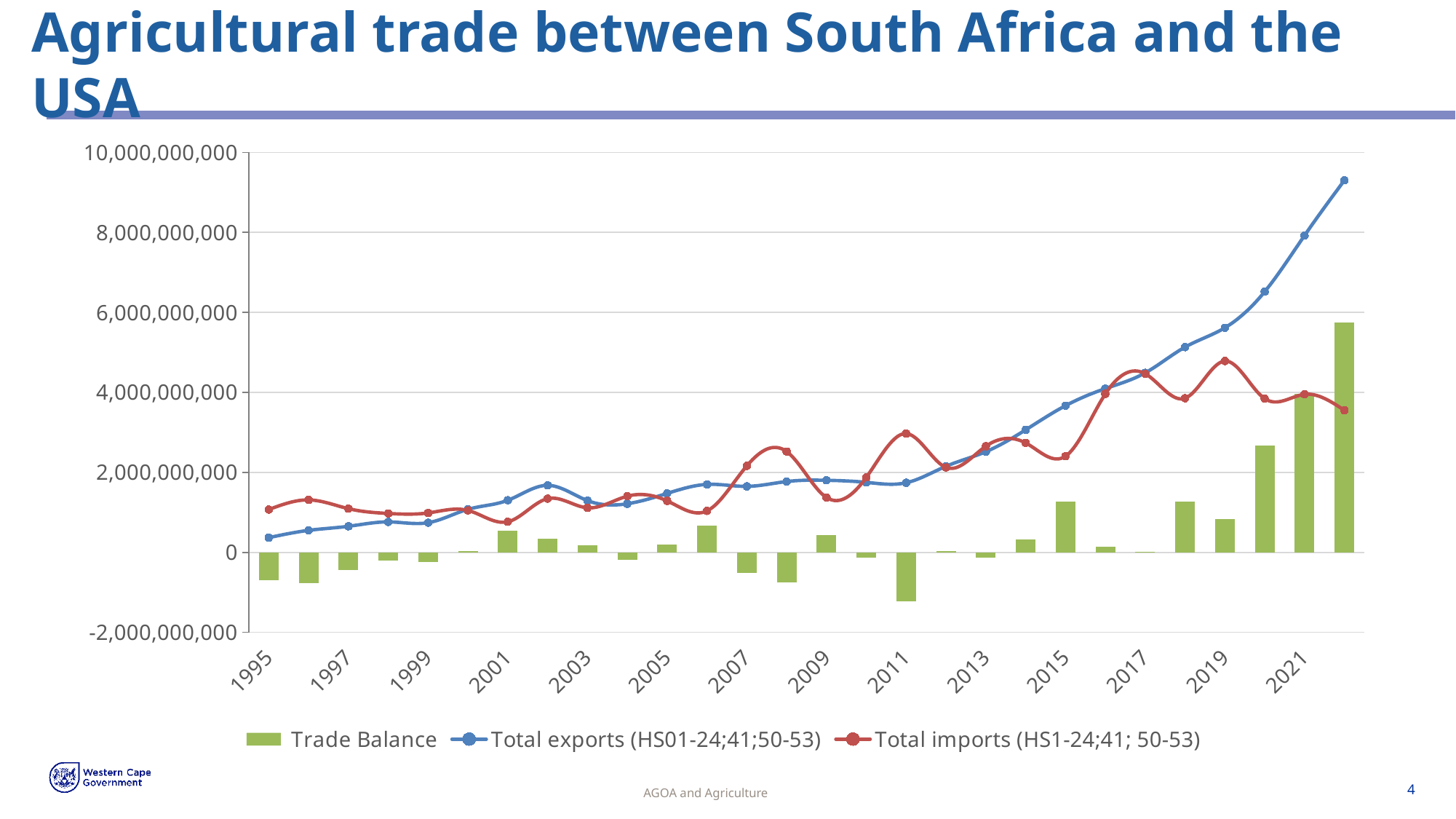
In 2015, which is larger, Total exports or Total imports? Total exports Is the Trade Balance in 2011 greater or less than 0? less Is the value for Total imports in 2021 greater or less than 2,000,000,000? greater What colour are the Trade Balance bars? Green What kind of chart is this? Combined bar and line chart Do Total exports rise or fall from 2013 to 2021? rise Which year has the lowest (most negative) Trade Balance? 2011 How many year labels are shown on the x axis? 14 How many series does the legend list? 3 In 2011, which is larger, Total exports or Total imports? Total imports Is the value for Total exports in 2021 greater or less than 6,000,000,000? greater